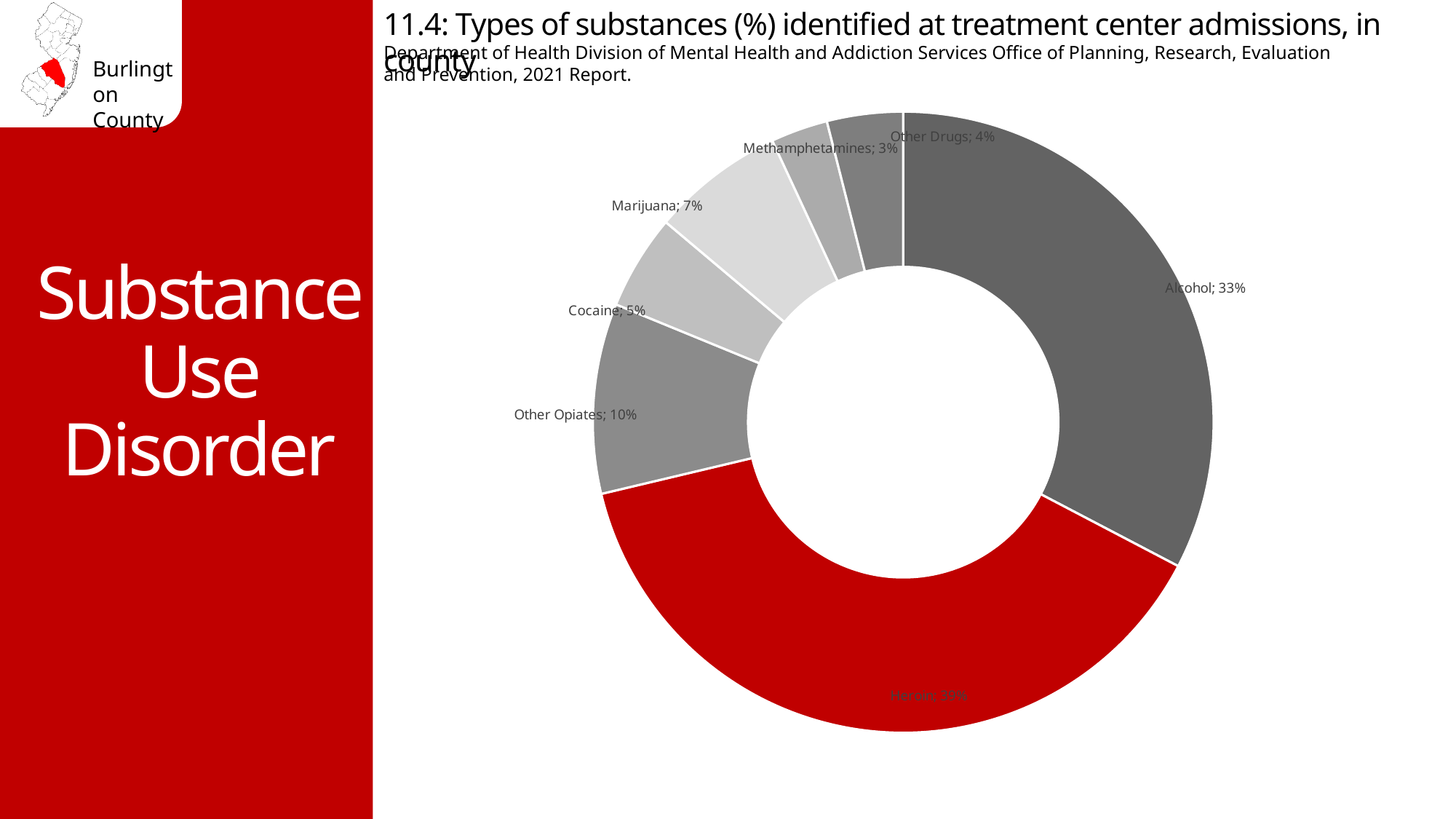
Which substance has the smallest share of the chart? Methamphetamines Which substance has the largest share of the chart? Heroin What percentage is shown for Methamphetamines? 3% What percentage of treatment center admissions identified Alcohol? 33% Which is larger, the share for Marijuana or the share for Other Drugs? Marijuana What percentage is shown for Other Opiates? 10% How many substance categories are shown in the chart? 7 What kind of chart is shown on the slide? Doughnut (pie) chart What is the difference in percentage points between Other Opiates and Cocaine? 5 Which slice of the chart is coloured red? Heroin What percentage is shown for Marijuana? 7% What percentage is shown for Cocaine? 5%